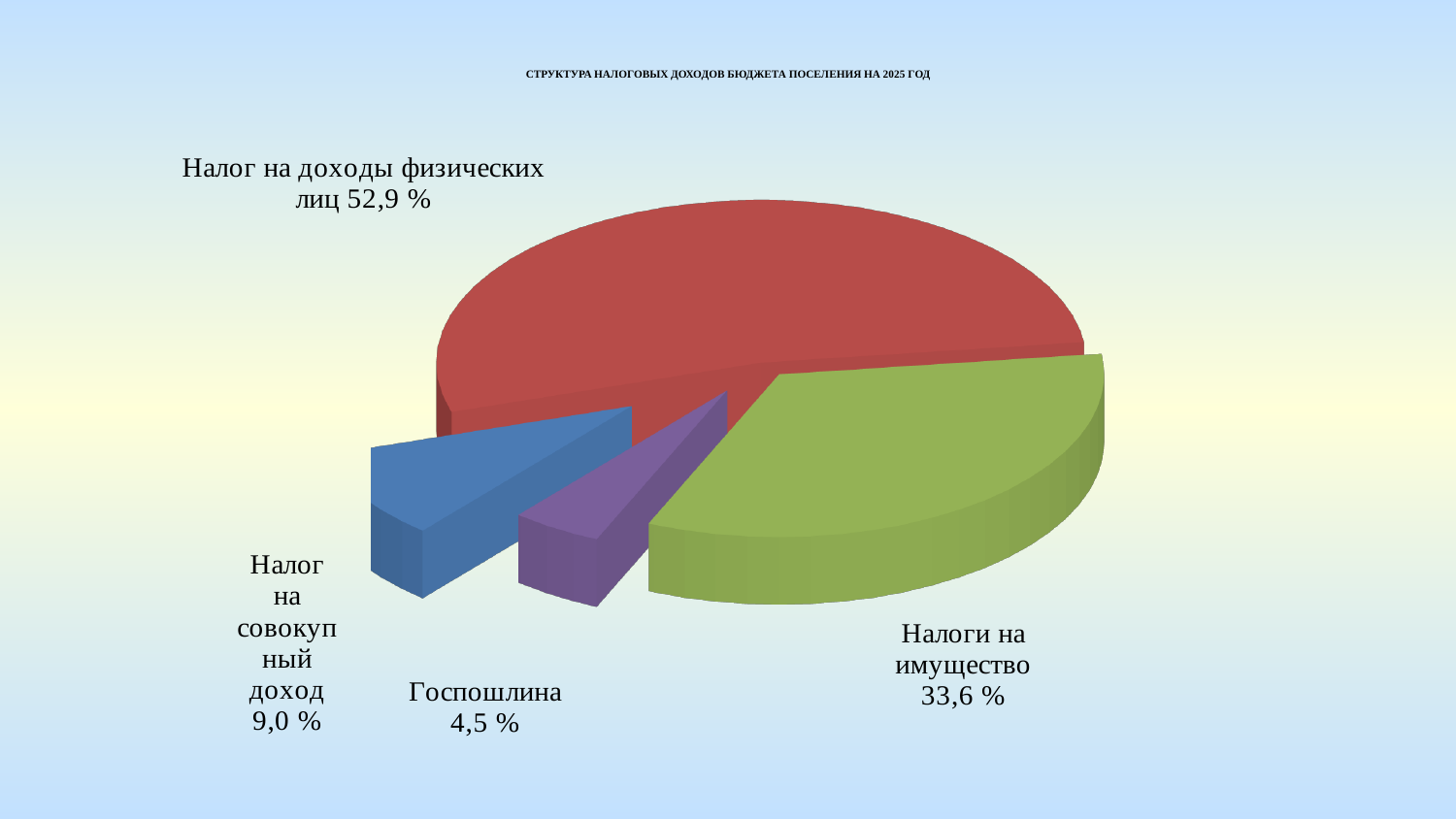
Как называется диаграмма на слайде? Структура налоговых доходов бюджета поселения на 2025 год Какова доля госпошлины? 4,5 % Какова доля налогов на имущество? 33,6 % На сколько процентных пунктов доля налога на доходы физических лиц больше доли налогов на имущество? 19,3 Что больше: доля налога на совокупный доход или доля госпошлины? Налог на совокупный доход Какой вид налоговых доходов имеет наибольшую долю? Налог на доходы физических лиц Какова доля налога на совокупный доход? 9,0 % Какой тип диаграммы показан на слайде? Круговая диаграмма Каким цветом показан сектор «Налоги на имущество»? Зелёным Какой вид налоговых доходов имеет наименьшую долю? Госпошлина Какова доля налога на доходы физических лиц в структуре налоговых доходов? 52,9 % Сколько секторов (категорий) показано на круговой диаграмме? 4